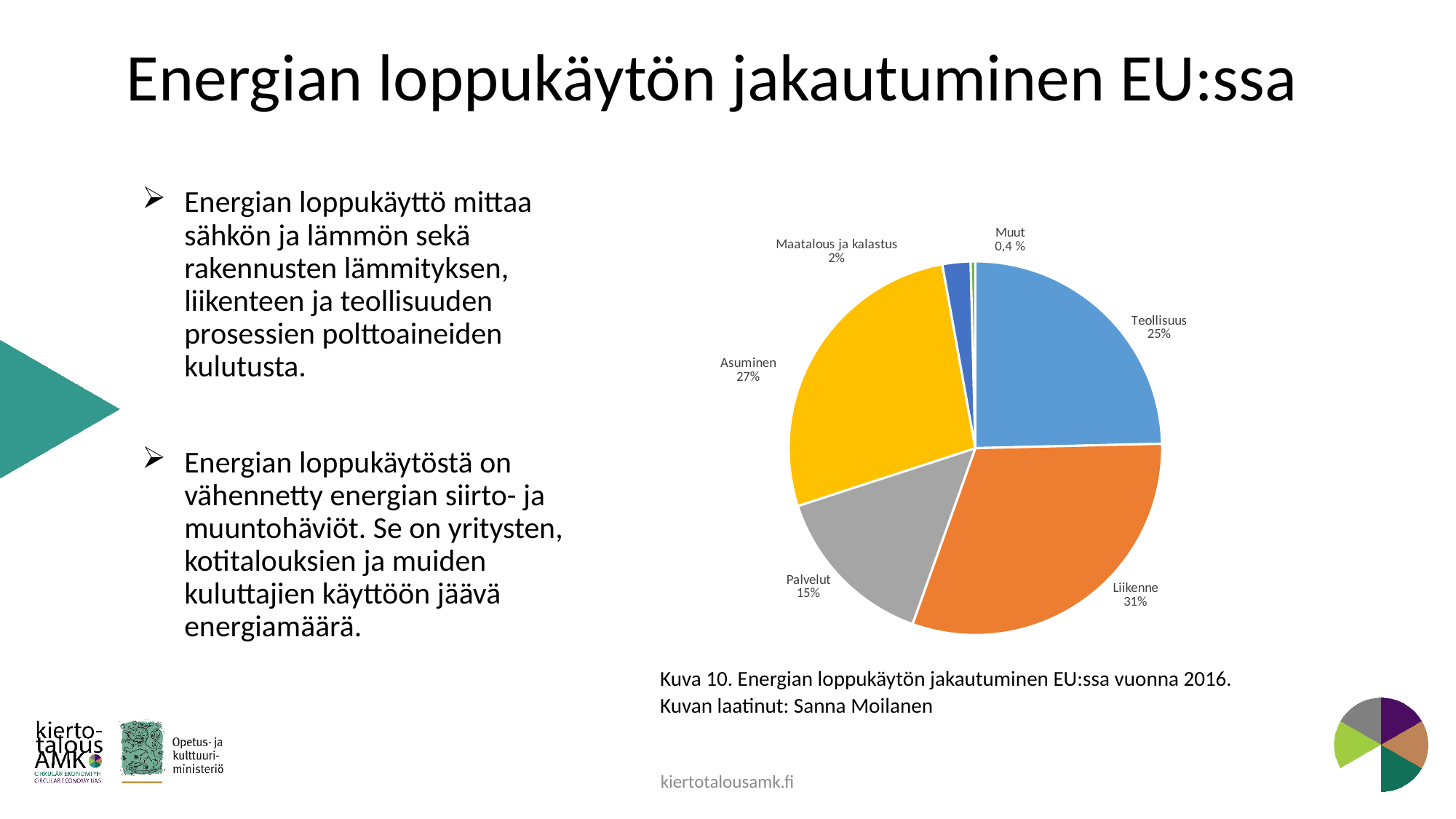
What is the difference in percentage points between Liikenne and Palvelut? 16 Which is larger, the share for Asuminen or the share for Teollisuus? Asuminen Which category has the smallest share of the pie? Muut What share of energy end use does Palvelut account for? 15% What share of energy end use does Liikenne account for? 31% What share of energy end use does Maatalous ja kalastus account for? 2% What kind of chart is shown on the slide? pie chart What share of energy end use does Teollisuus account for? 25% Which category has the largest share of the pie? Liikenne What share of energy end use does Muut account for? 0,4 % How many categories does the pie chart show? 6 What share of energy end use does Asuminen account for? 27%